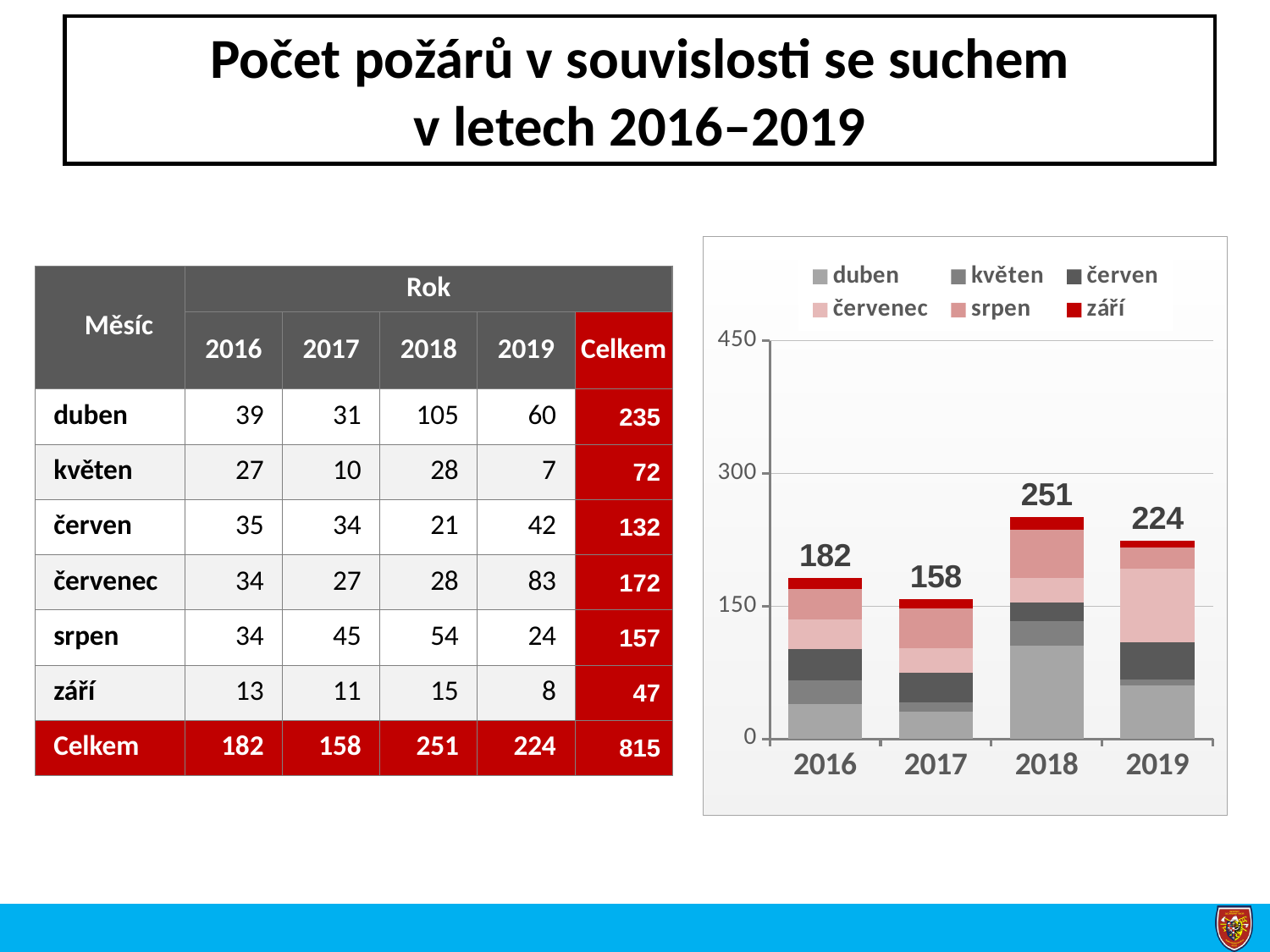
Which year has the highest total bar in the chart? 2018 What is the total of the stacked bar for 2016? 182 Which colour represents the series 'září' in the chart legend? red Which bar is taller, 2016 or 2019? 2019 What kind of chart is shown on the right of the slide? stacked bar chart How many series does the chart legend list? 6 What is the difference between the total for 2018 and the total for 2017? 93 How many years (bars) are shown on the x axis of the chart? 4 Is the total for 2017 greater or less than 300? less What is the total value labelled on the bar for 2018? 251 Which year has the lowest total bar in the chart? 2017 What is the difference between the total for 2019 and the total for 2016? 42